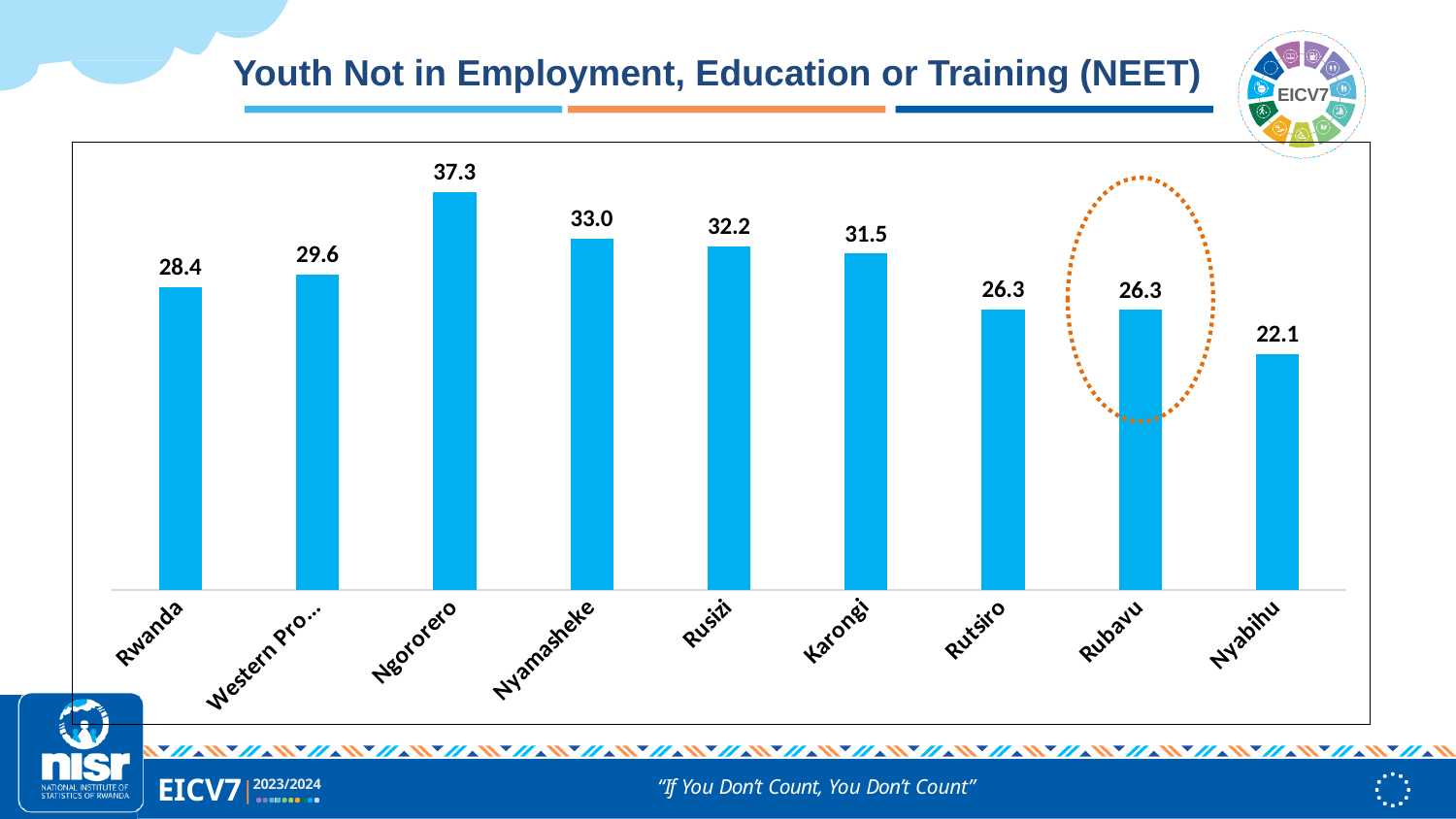
What is the value for Nyabihu? 22.1 Which is larger, the value for Karongi or the value for Rutsiro? Karongi Which category has the highest value? Ngororero What kind of chart is shown on the slide? Bar chart How many categories are shown on the chart? 9 What is the value for Ngororero? 37.3 What is the value for Rubavu? 26.3 What is the difference between the values for Nyamasheke and Rusizi? 0.8 What is the difference between the values for Ngororero and Nyabihu? 15.2 What is the value for Rwanda? 28.4 What is the title of the chart? Youth Not in Employment, Education or Training (NEET) Which category has the lowest value? Nyabihu